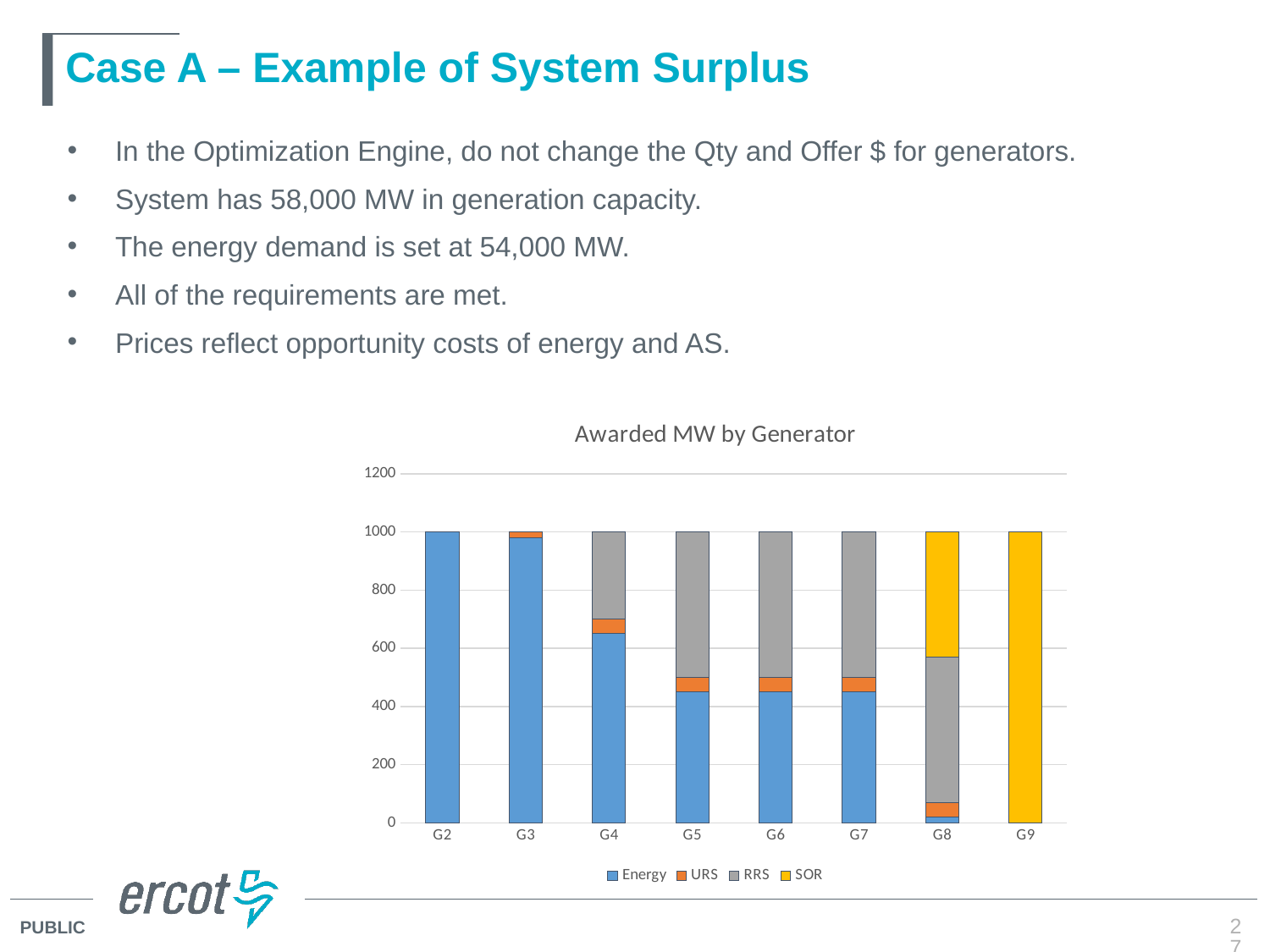
What kind of chart is shown on the slide? Stacked bar chart What is the Energy value for generator G2? 1000 Is the Energy value for G8 greater or less than 200? less Is the Energy value for G5 greater or less than 600? less What is the SOR value for generator G9? 1000 How many series does the chart legend list? 4 Which series are listed in the chart legend? Energy, URS, RRS, SOR How many generators are shown on the x axis of the chart? 8 What is the total awarded MW for generator G2? 1000 Is the Energy value for G4 greater or less than 600? greater Which generator has a larger Energy value, G3 or G6? G3 What is the title of the chart? Awarded MW by Generator